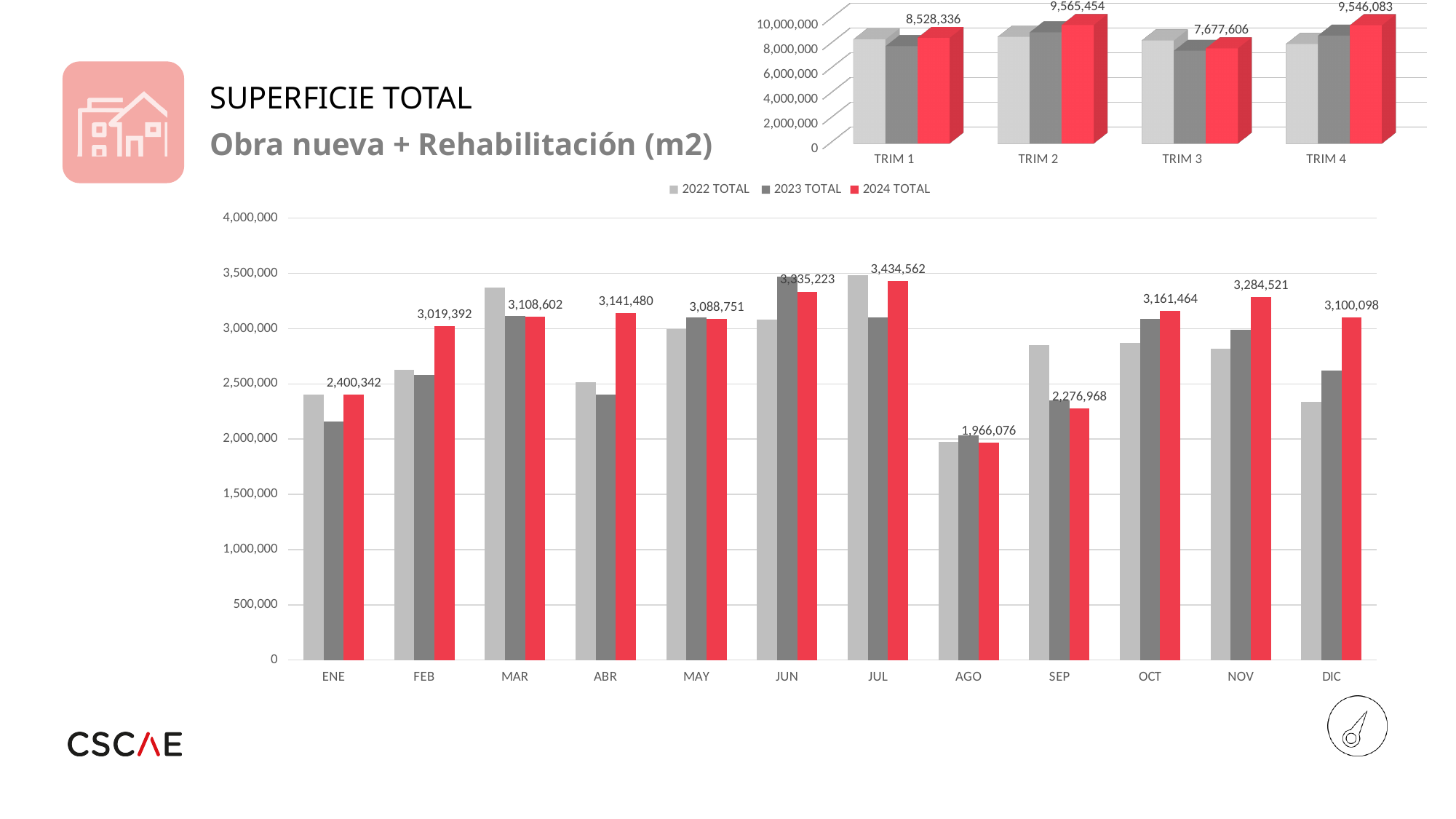
In the monthly chart at the bottom, is the 2022 TOTAL value for MAR greater or less than 3,000,000? greater How many series does the legend of the monthly chart at the bottom list? 3 In the monthly chart at the bottom, what is the 2024 TOTAL value for JUL? 3,434,562 In the monthly chart at the bottom, what is the 2024 TOTAL value for ENE? 2,400,342 In the monthly chart at the bottom, which month has the highest 2024 TOTAL value? JUL In the monthly chart at the bottom, which month has the lowest 2024 TOTAL value? AGO In the monthly chart at the bottom, is the 2024 TOTAL value for NOV larger or smaller than the 2024 TOTAL value for OCT? larger In the quarterly chart at the top right, which quarter has the lowest 2024 TOTAL value? TRIM 3 In the quarterly chart at the top right, what is the difference between the 2024 TOTAL values for TRIM 2 and TRIM 3? 1,887,848 In the quarterly chart at the top right, what is the 2024 TOTAL value for TRIM 3? 7,677,606 In the monthly chart at the bottom, what is the difference between the 2024 TOTAL values for JUL and AGO? 1,468,486 How many months are shown on the x axis of the monthly chart at the bottom? 12